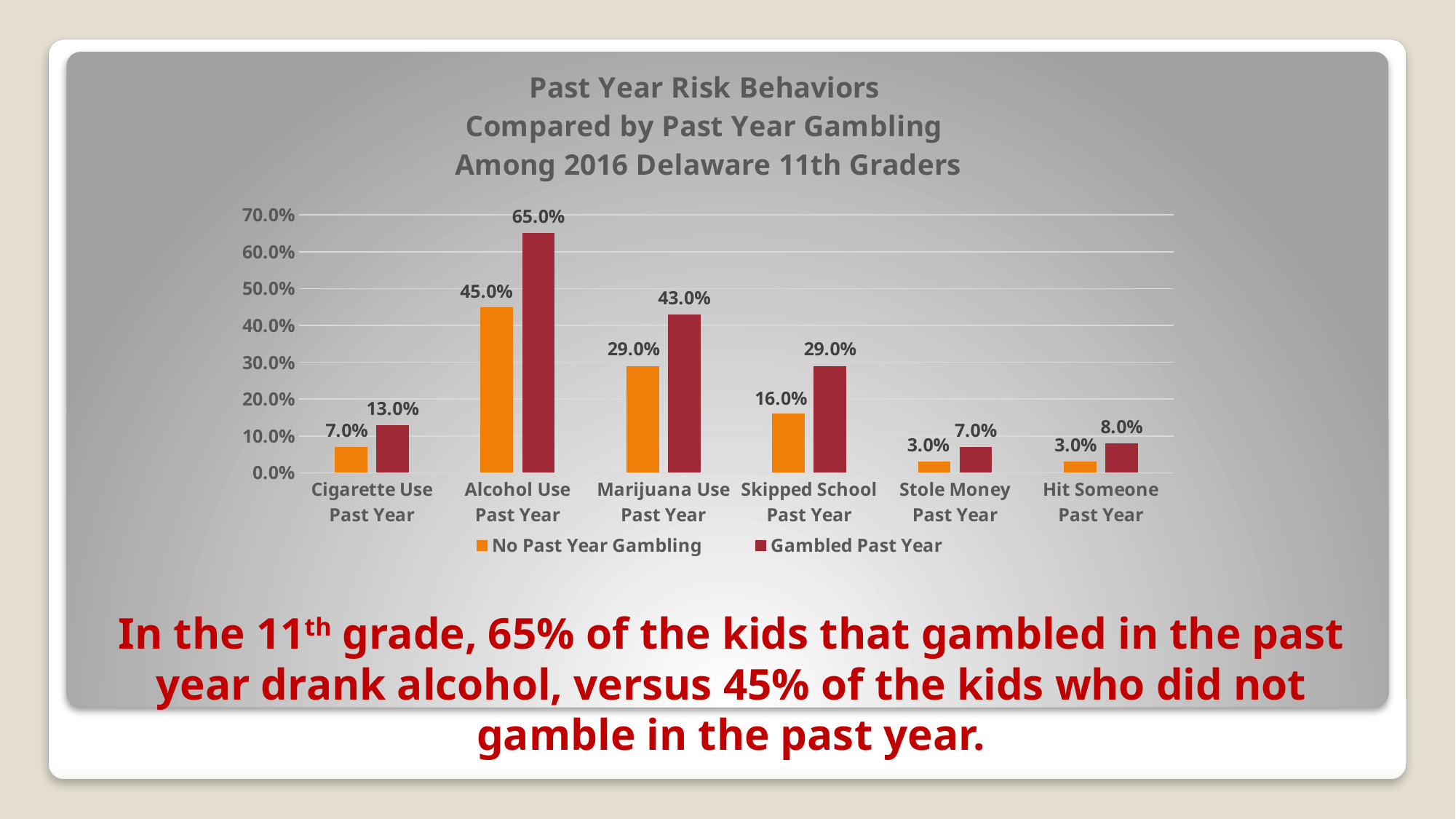
What is the value for Alcohol Use Past Year in the Gambled Past Year series? 65.0% What kind of chart is shown on the slide? Bar chart How many series does the legend list? 2 How many categories are shown on the x axis? 6 What is the value for Skipped School Past Year in the No Past Year Gambling series? 16.0% What is the value for Cigarette Use Past Year in the Gambled Past Year series? 13.0% What is the difference between the Gambled Past Year and No Past Year Gambling values for Alcohol Use Past Year? 20.0% Which category has the highest value in the Gambled Past Year series? Alcohol Use Past Year Which category has the lowest value in the Gambled Past Year series? Stole Money Past Year Which is larger for Hit Someone Past Year: the No Past Year Gambling value or the Gambled Past Year value? Gambled Past Year What is the difference between the Gambled Past Year and No Past Year Gambling values for Marijuana Use Past Year? 14.0% What colour are the bars for the No Past Year Gambling series? Orange